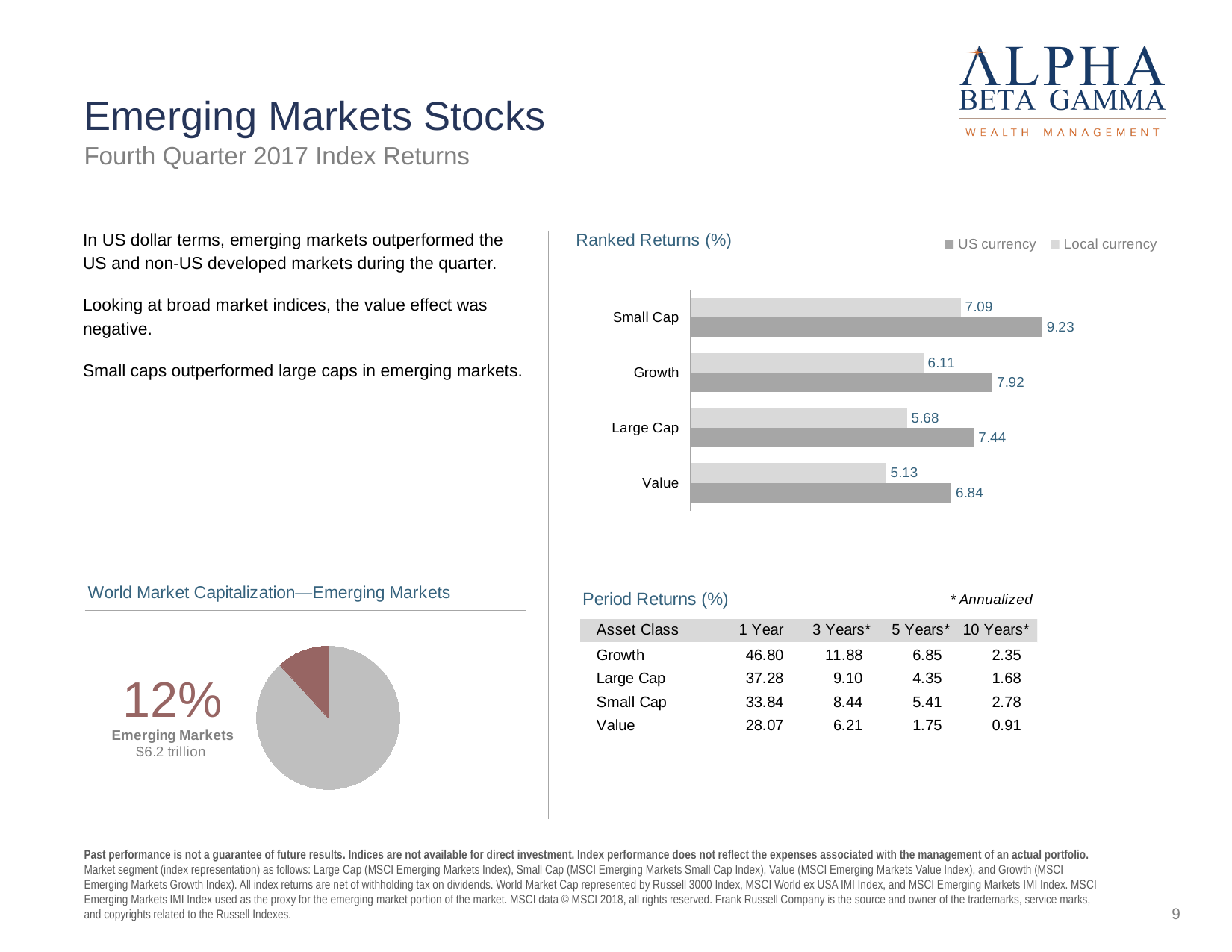
In the Ranked Returns (%) chart, which category has the lowest Local currency return? Value In the Ranked Returns (%) chart, what is the US currency value for Value? 6.84 In the Ranked Returns (%) chart, which category has the highest US currency return? Small Cap How many categories are shown in the Ranked Returns (%) chart? 4 In the Ranked Returns (%) chart, what is the difference between the US currency and Local currency values for Large Cap? 1.76 What kind of chart is the Ranked Returns (%) chart? Bar chart In the Ranked Returns (%) chart, which is larger: the US currency value for Growth or the US currency value for Large Cap? Growth In the Ranked Returns (%) chart, what is the US currency value for Small Cap? 9.23 In the World Market Capitalization—Emerging Markets pie chart, what share of the pie do Emerging Markets represent? 12% How many series does the legend of the Ranked Returns (%) chart list? 2 In the Ranked Returns (%) chart, what is the Local currency value for Growth? 6.11 What are the two series named in the legend of the Ranked Returns (%) chart? US currency and Local currency